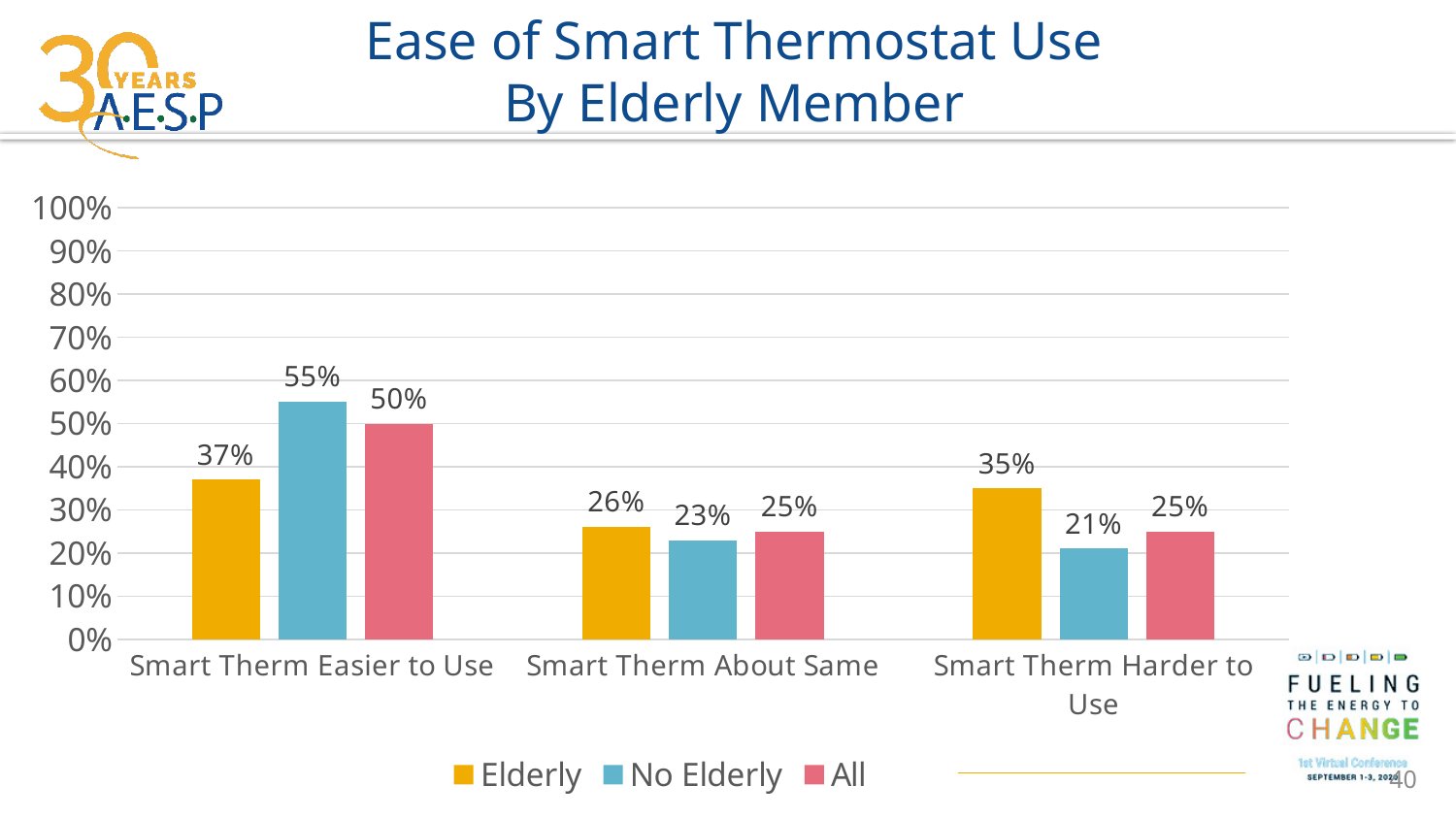
How many categories are shown on the x axis? 3 Is the value for No Elderly in the Smart Therm Easier to Use category greater or less than 50%? greater What is the value for No Elderly in the Smart Therm Harder to Use category? 21% What is the value for All in the Smart Therm About Same category? 25% What is the difference between the No Elderly and Elderly values in the Smart Therm Easier to Use category? 18% What is the value for Elderly in the Smart Therm Easier to Use category? 37% What is the title of the chart? Ease of Smart Thermostat Use By Elderly Member In the Smart Therm Harder to Use category, which is larger: Elderly or No Elderly? Elderly What kind of chart is shown on the slide? Bar chart Which category has the lowest value for the Elderly series? Smart Therm About Same Which category has the highest value for the No Elderly series? Smart Therm Easier to Use How many series does the legend list? 3